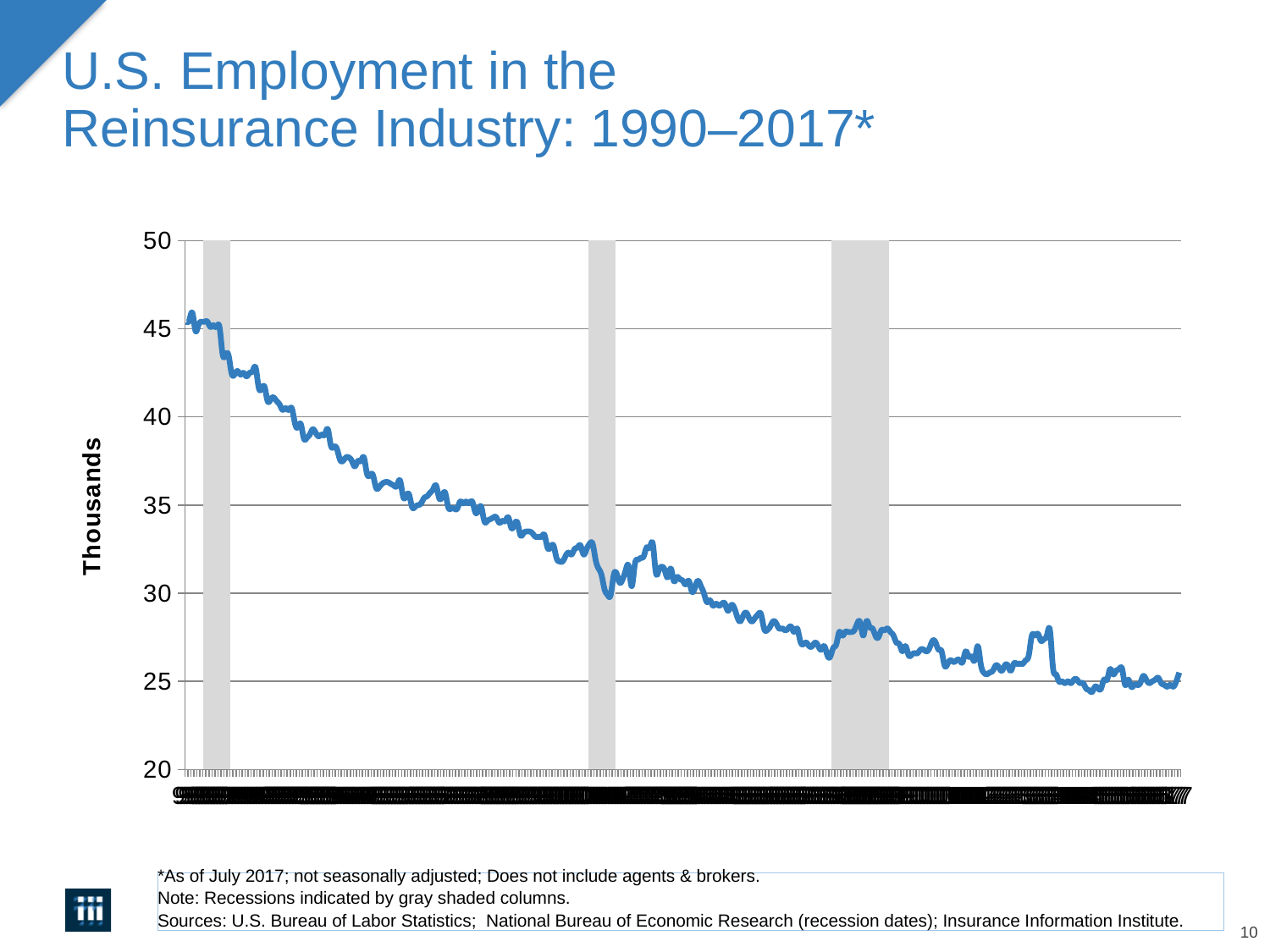
Is the lowest point of the line greater or less than 20? greater Do the values in the chart generally rise or fall from left to right along the x axis? fall Is the value at the end of the line (right end) greater or less than 20? greater What is the label on the vertical axis of the chart? Thousands How many gray shaded recession columns are shown on the chart? 3 Is the value at the start of the line (left end) greater or less than 40? greater What kind of chart is shown on the slide? line chart Which end of the line is higher, the left end or the right end? left end